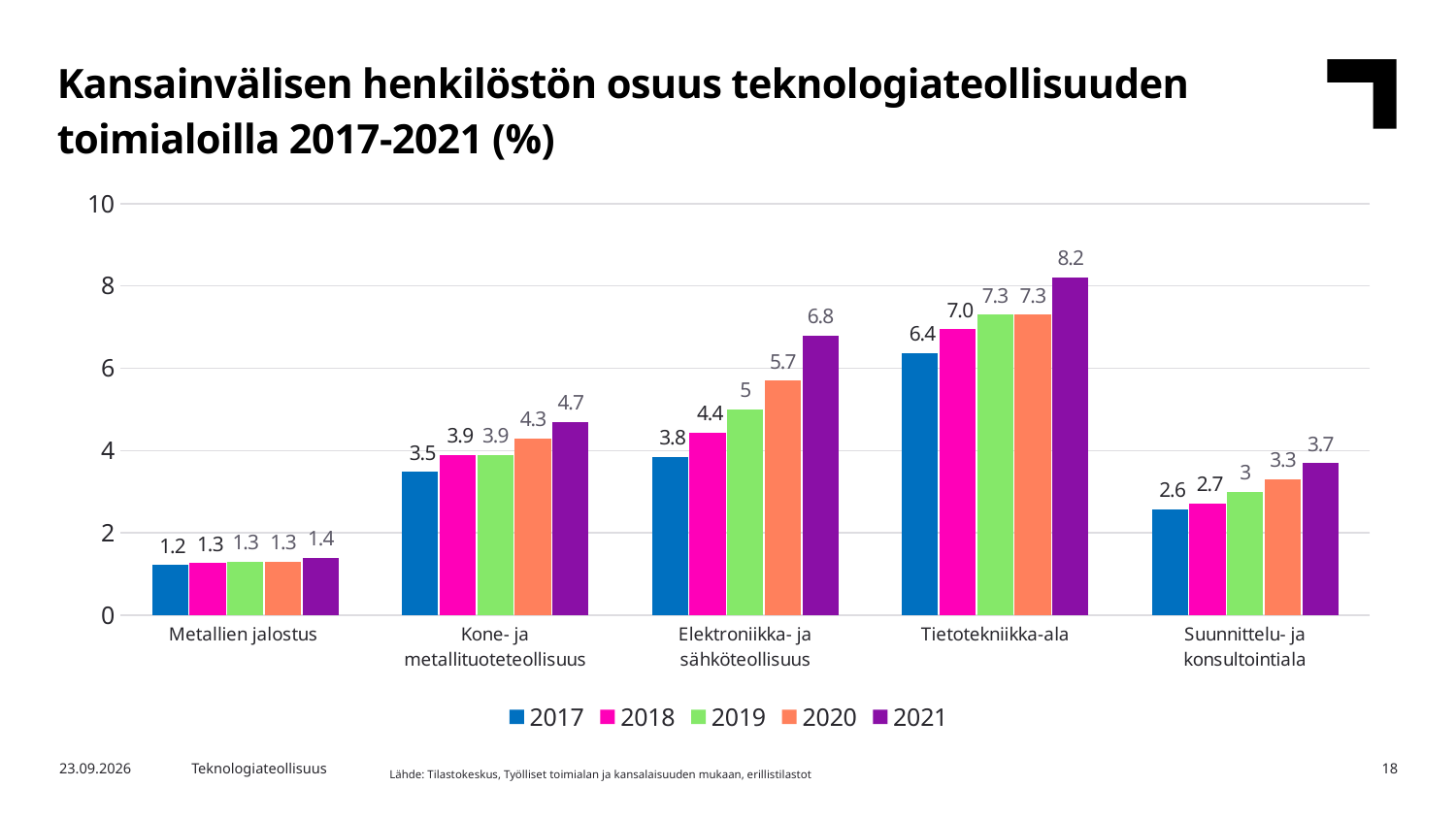
Do the values for Tietotekniikka-ala rise or fall from 2017 to 2021? Rise What is the value for Suunnittelu- ja konsultointiala in 2017? 2.6 What is the difference between the 2021 and 2017 values for Elektroniikka- ja sähköteollisuus? 3 Which is larger: the 2020 value for Kone- ja metallituoteteollisuus or the 2020 value for Suunnittelu- ja konsultointiala? Kone- ja metallituoteteollisuus What is the value for Elektroniikka- ja sähköteollisuus in 2019? 5 How many series does the legend list? 5 Which category has the lowest value in 2017? Metallien jalostus What kind of chart is shown on the slide? Bar chart Which category has the highest value in 2021? Tietotekniikka-ala Is the 2021 value for Kone- ja metallituoteteollisuus greater or less than 4? greater How many categories are shown on the x axis? 5 What is the value for Tietotekniikka-ala in 2021? 8.2